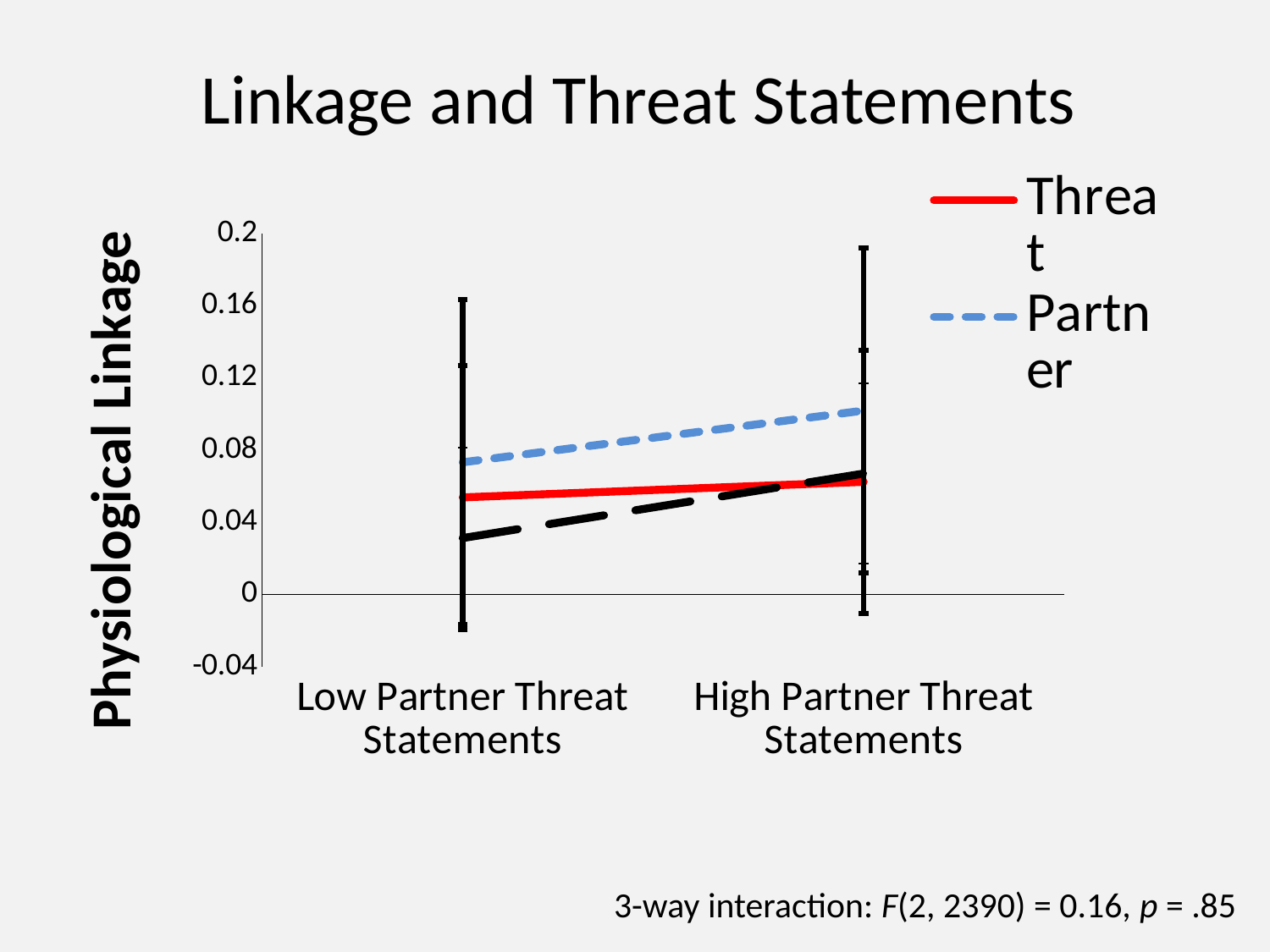
Is the Threat value for Low Partner Threat Statements greater or less than 0.08? less Is the Partner value for High Partner Threat Statements greater or less than 0.08? greater How many categories are shown on the x axis? 2 How many series does the legend list? 2 At High Partner Threat Statements, which series has the larger value, Threat or Partner? Partner What is the label on the y axis? Physiological Linkage Is the Threat value for High Partner Threat Statements greater or less than 0.04? greater Does the Partner line rise or fall from Low Partner Threat Statements to High Partner Threat Statements? Rises What kind of chart is shown on the slide? Line chart What is the title of the chart? Linkage and Threat Statements At Low Partner Threat Statements, which series has the larger value, Threat or Partner? Partner